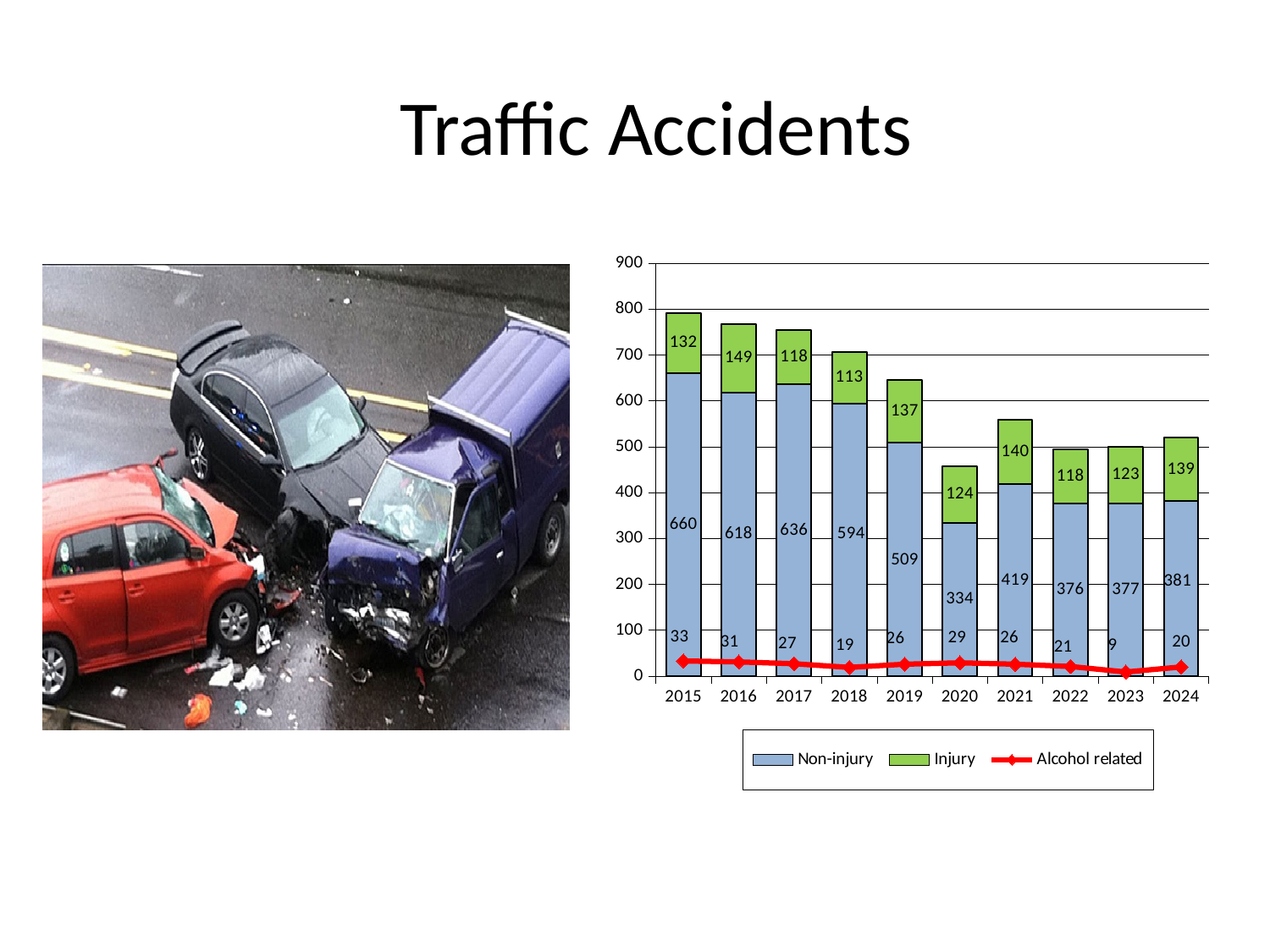
What is the difference between the Non-injury values for 2015 and 2020? 326 How many series does the legend list? 3 Which year has the highest Non-injury value? 2015 Which year has the lowest Alcohol related value? 2023 Which is larger, the Injury value for 2016 or the Injury value for 2018? 2016 What is the total of the stacked bar (Non-injury plus Injury) for 2020? 458 What is the Alcohol related value for 2023? 9 What is the Injury value for 2021? 140 What is the Non-injury value for 2015? 660 Which year has the lowest Non-injury value? 2020 Does the Non-injury value generally rise or fall from 2015 to 2020? fall How many years are shown on the x axis? 10